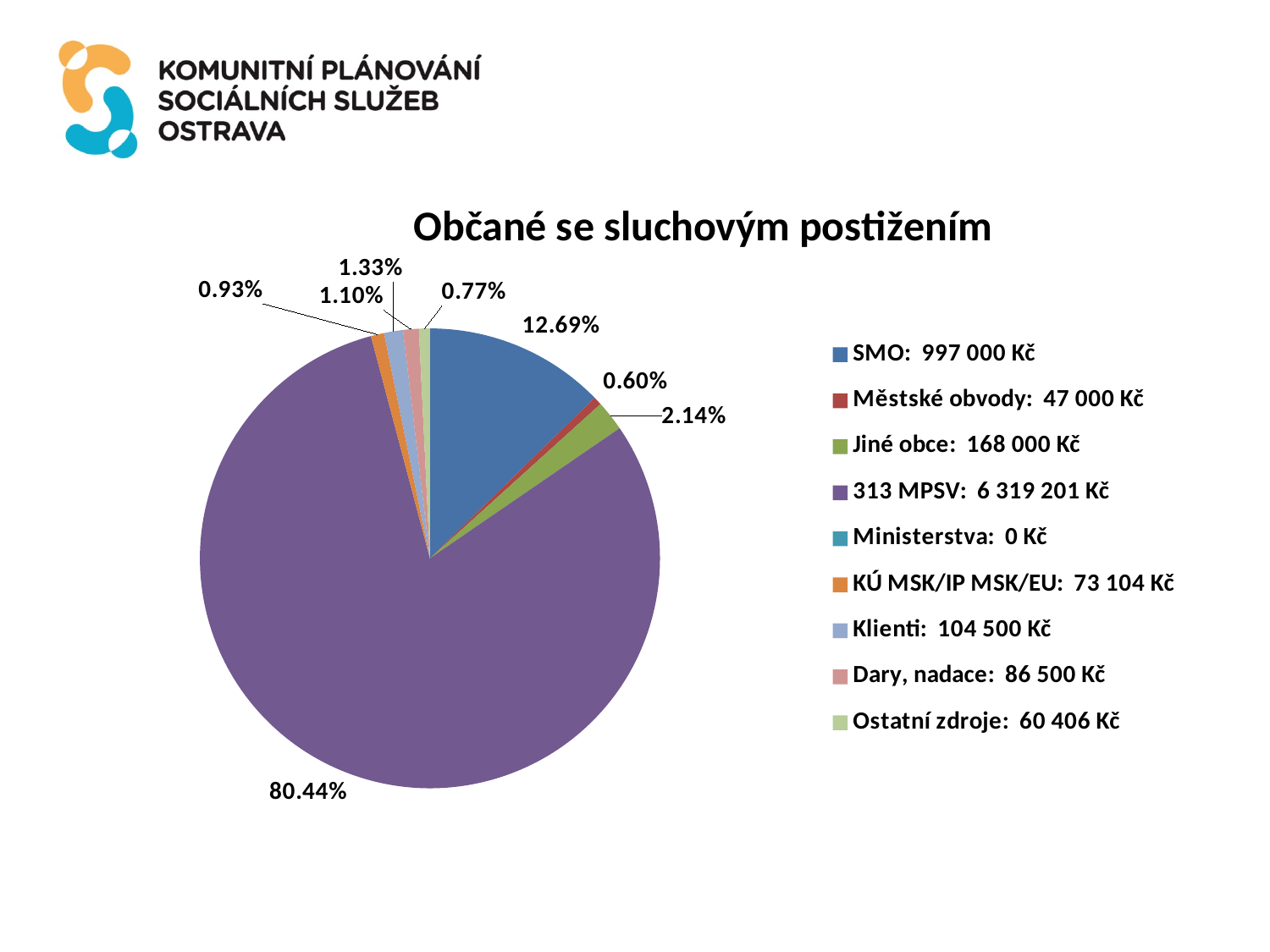
What share of the pie does Jiné obce represent? 2.14% What share of the pie does SMO represent? 12.69% What is the title of the chart? Občané se sluchovým postižením What value does the legend give for Klienti? 104 500 Kč What is the difference between the values for Jiné obce and Městské obvody? 121 000 Kč What value does the legend give for 313 MPSV? 6 319 201 Kč What value does the legend give for SMO? 997 000 Kč Which is larger, the value for Klienti or the value for Dary, nadace? Klienti What share of the pie does 313 MPSV represent? 80.44% Which source has the largest share of the pie? 313 MPSV What kind of chart is shown on the slide? pie chart How many entries does the chart legend list? 9